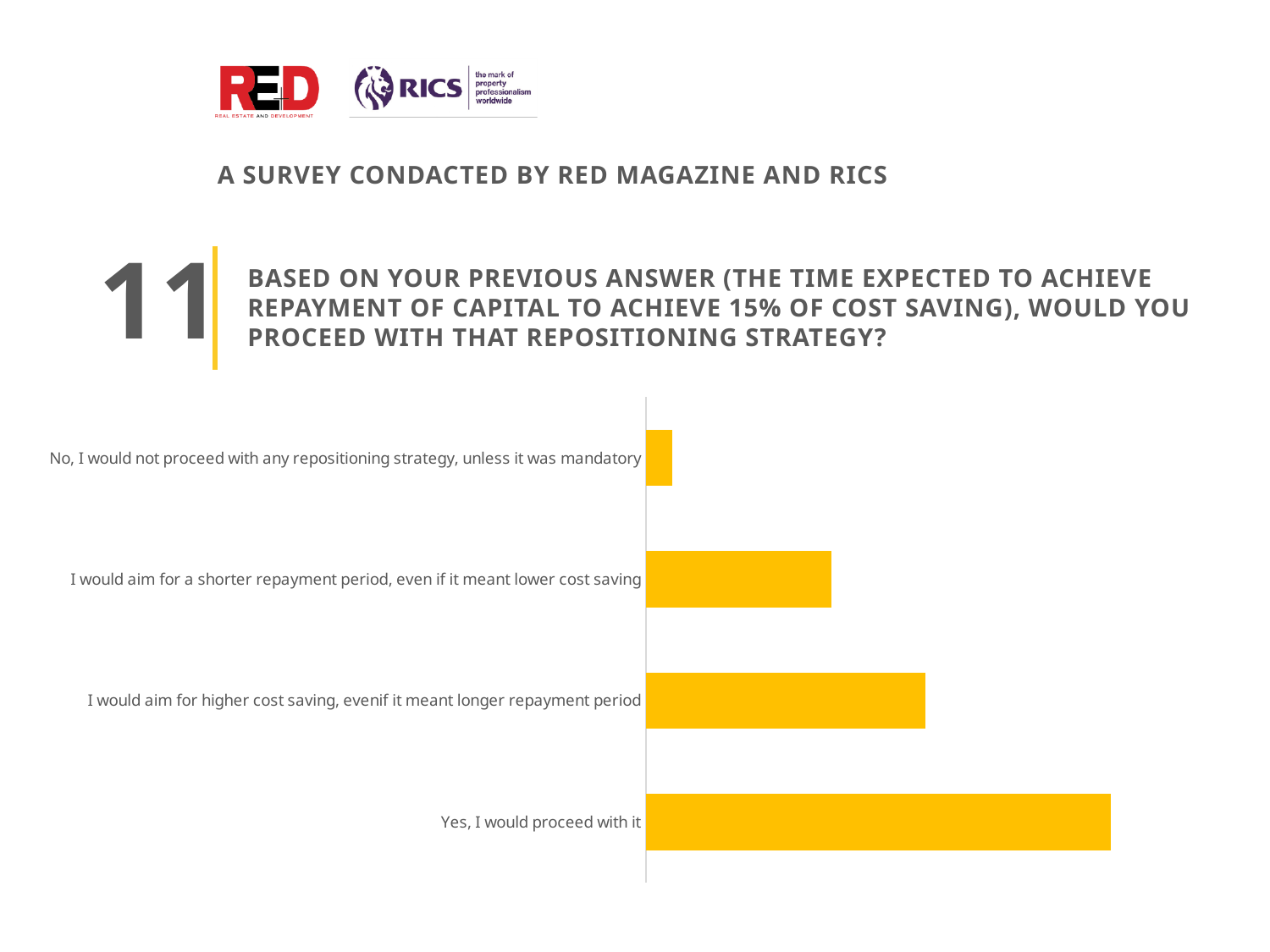
What kind of chart is shown on the slide? Bar chart How many categories (response options) does the bar chart show? 4 Which bar is longer: "Yes, I would proceed with it" or "I would aim for higher cost saving, even if it meant longer repayment period"? Yes, I would proceed with it Which bar is shorter: "No, I would not proceed with any repositioning strategy, unless it was mandatory" or "I would aim for a shorter repayment period, even if it meant lower cost saving"? No, I would not proceed with any repositioning strategy, unless it was mandatory Which response option has the shortest bar? No, I would not proceed with any repositioning strategy, unless it was mandatory What colour are the bars in the chart? Yellow Which response option has the longest bar? Yes, I would proceed with it Are the bars in the chart oriented horizontally or vertically? Horizontally Which bar is longer: "I would aim for higher cost saving, even if it meant longer repayment period" or "I would aim for a shorter repayment period, even if it meant lower cost saving"? I would aim for higher cost saving, even if it meant longer repayment period Which response option is listed at the bottom of the chart? Yes, I would proceed with it